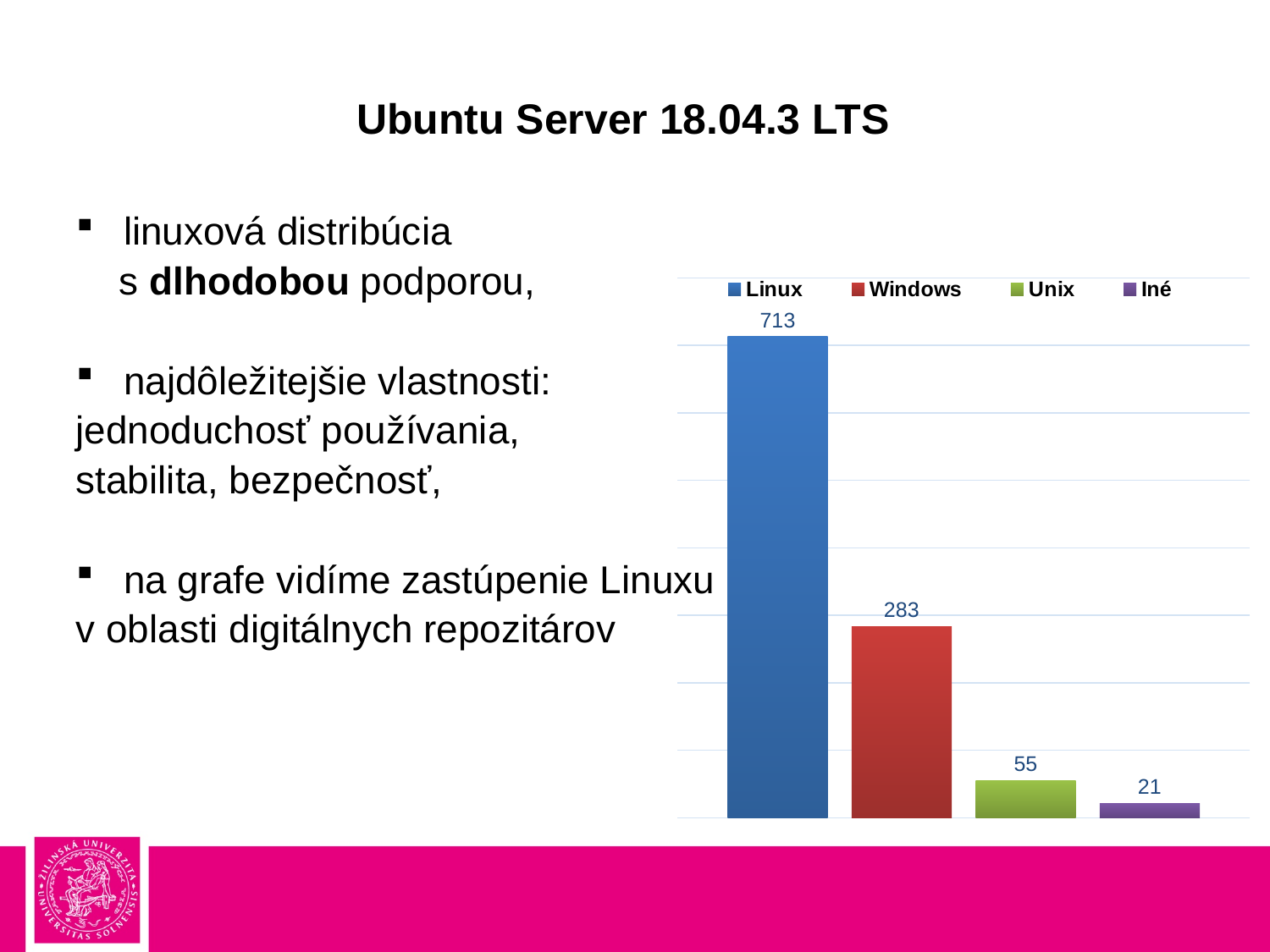
What is the difference between the values for Unix and Iné? 34 How many categories are shown in the chart? 4 What is the value for Windows? 283 What is the value for Linux? 713 How many entries does the legend list? 4 What kind of chart is shown on the slide? bar chart Which category has the highest value? Linux What is the value for Unix? 55 Which category has the lowest value? Iné Which is larger, the value for Windows or the value for Unix? Windows What is the value for Iné? 21 What is the difference between the values for Linux and Windows? 430